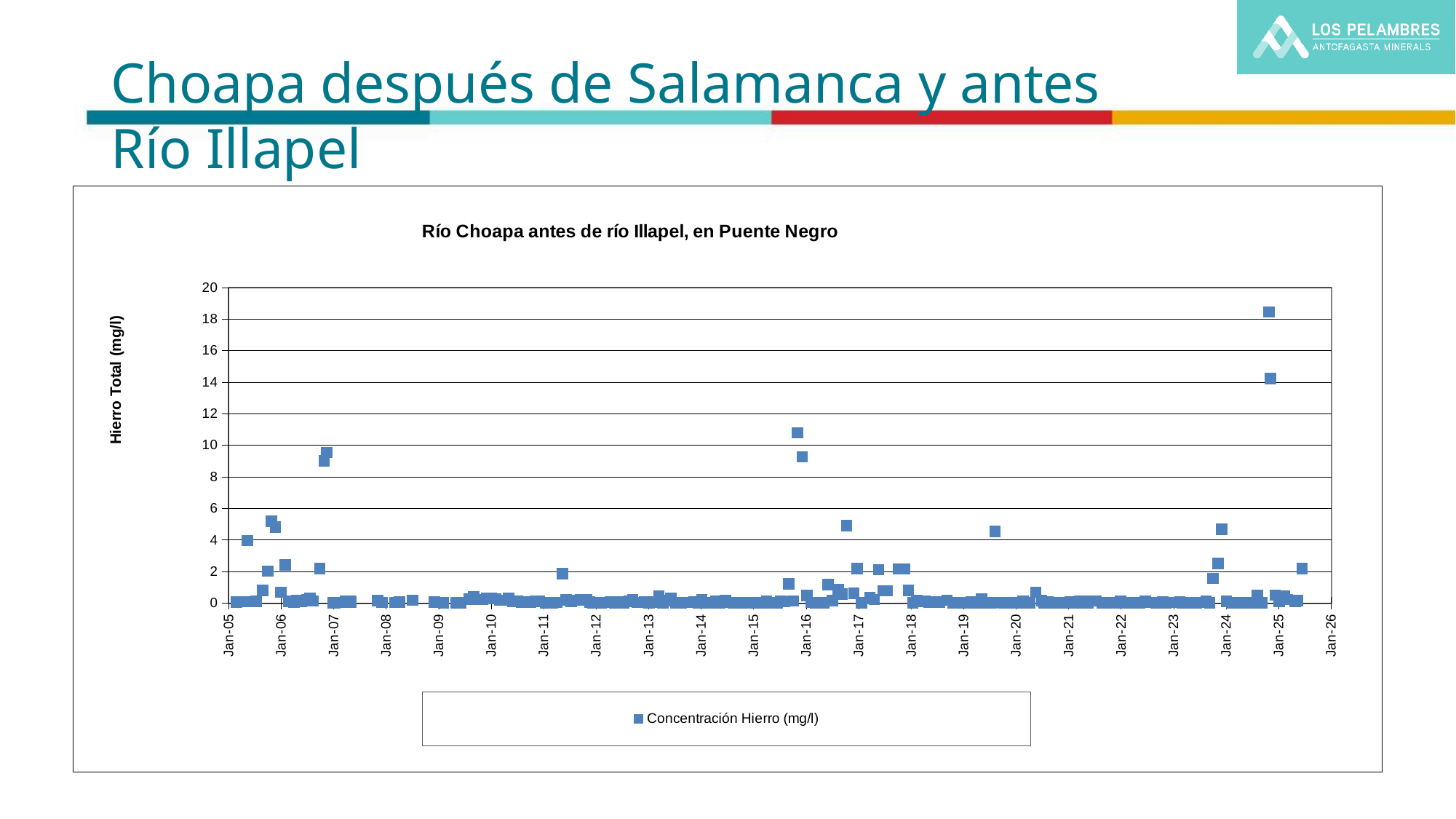
What is the maximum value shown on the y axis? 20 Is the highest value plotted near Jan-16 greater or less than 10? greater Is the highest plotted value on the chart greater or less than 20? less Is the isolated high value plotted between Jan-19 and Jan-20 greater or less than 4? greater What is the title of the chart? Río Choapa antes de río Illapel, en Puente Negro What is the label of the series in the legend? Concentración Hierro (mg/l) What kind of chart is shown on the slide? Scatter chart How many series does the legend list? 1